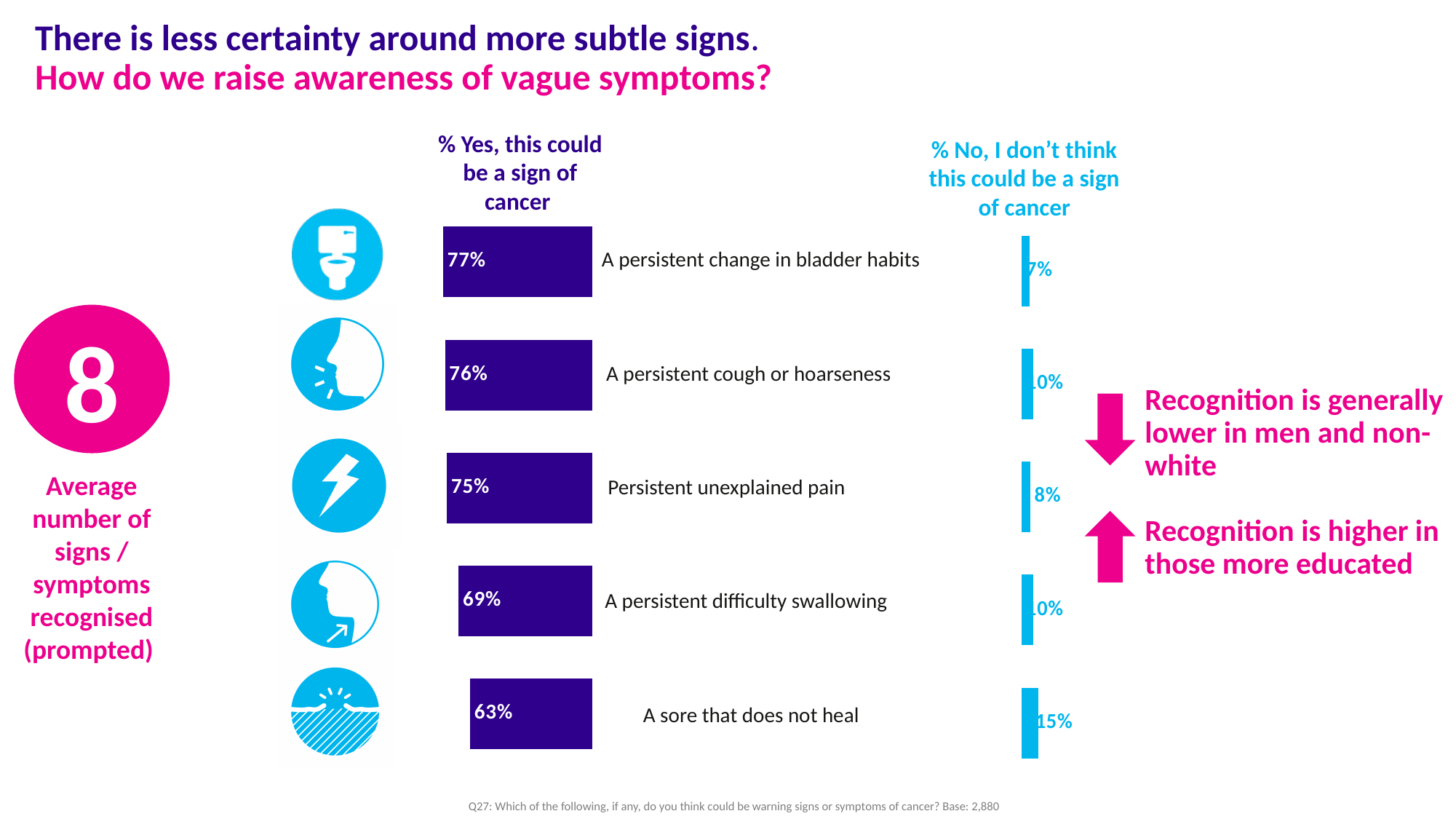
In the '% No, I don't think this could be a sign of cancer' chart, which symptom has the highest percentage? A sore that does not heal What kind of chart is the '% Yes, this could be a sign of cancer' chart? Bar chart In the '% No, I don't think this could be a sign of cancer' chart, what is the value for 'Persistent unexplained pain'? 8% In the '% Yes, this could be a sign of cancer' chart, what is the difference between the values for 'A persistent change in bladder habits' and 'A sore that does not heal'? 14% How many symptoms are listed in the '% Yes, this could be a sign of cancer' chart? 5 In the '% Yes, this could be a sign of cancer' chart, what is the value for 'A sore that does not heal'? 63% In the '% Yes, this could be a sign of cancer' chart, which symptom has the highest percentage? A persistent change in bladder habits In the '% Yes, this could be a sign of cancer' chart, what percentage said a persistent change in bladder habits could be a sign of cancer? 77% In the '% Yes, this could be a sign of cancer' chart, which is larger: the value for 'Persistent unexplained pain' or 'A persistent difficulty swallowing'? Persistent unexplained pain In the '% No, I don't think this could be a sign of cancer' chart, what is the value for 'A sore that does not heal'? 15% In the '% Yes, this could be a sign of cancer' chart, what is the value for 'A persistent difficulty swallowing'? 69% In the '% Yes, this could be a sign of cancer' chart, which symptom has the lowest percentage? A sore that does not heal